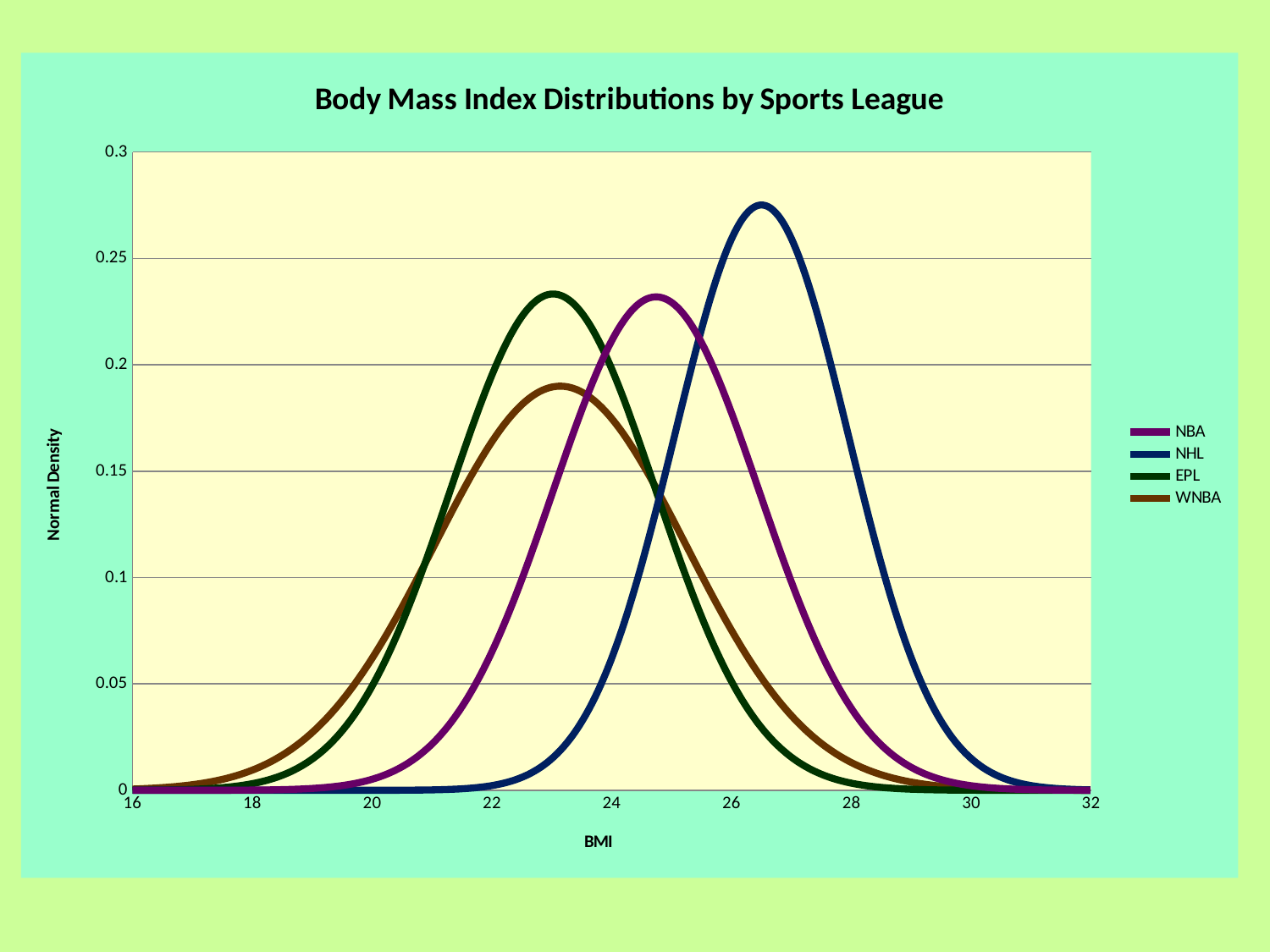
Is the peak value of the WNBA curve greater or less than 0.2? less What is the title of the chart? Body Mass Index Distributions by Sports League Is the peak value of the NBA curve greater or less than 0.25? less What kind of chart is shown on the slide? Line chart What is the label of the vertical axis? Normal Density Which series has its peak at the highest BMI value? NHL Which has a higher peak density, the NHL curve or the NBA curve? NHL Is the peak value of the NHL curve greater or less than 0.25? greater How many series does the legend list? 4 Which series has the lowest peak density? WNBA Which series reaches the highest peak density? NHL